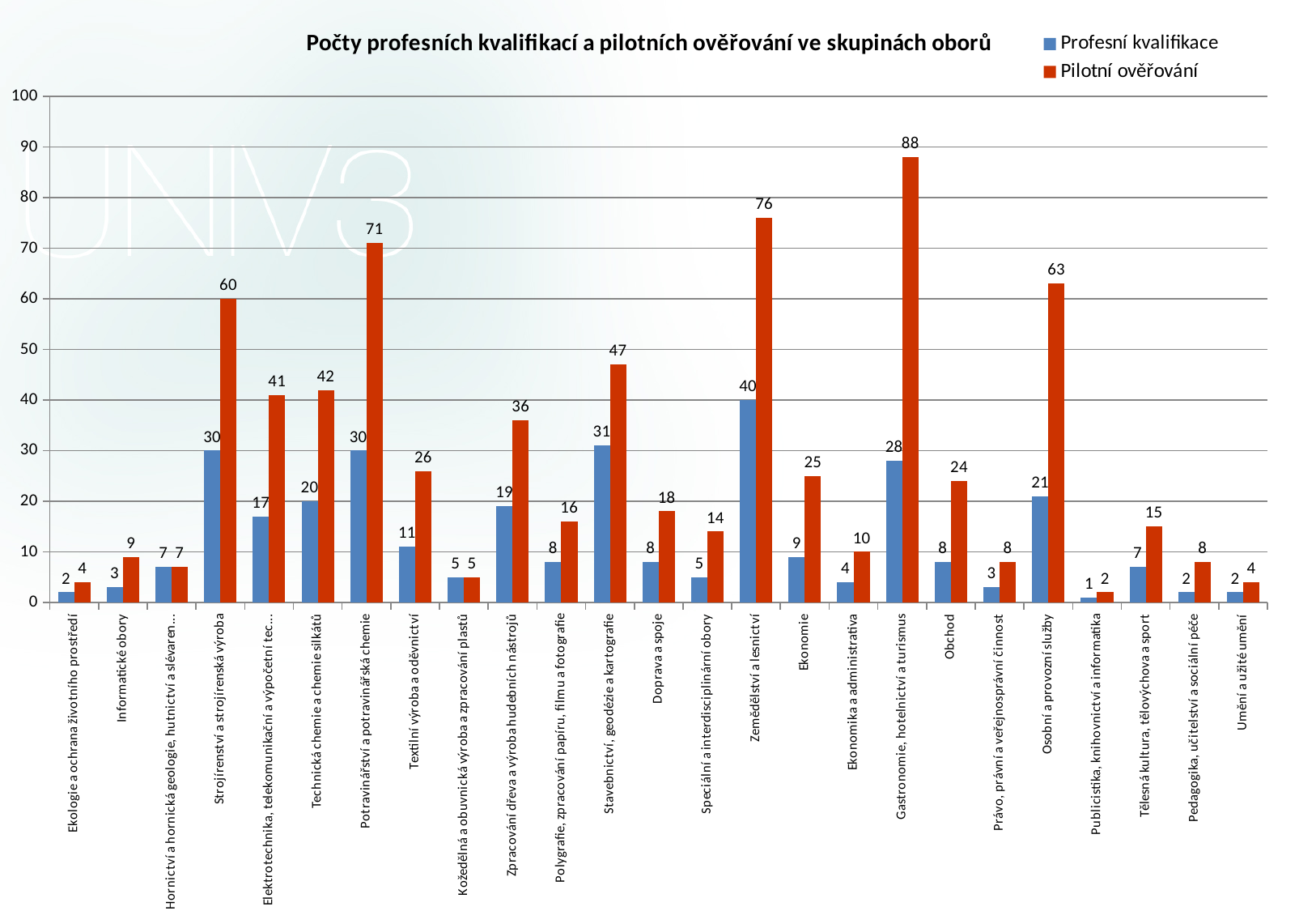
Which category has the highest value for Pilotní ověřování? Gastronomie, hotelnictví a turismus Which is larger: Pilotní ověřování for Strojírenství a strojírenská výroba or Pilotní ověřování for Stavebnictví, geodézie a kartografie? Strojírenství a strojírenská výroba What kind of chart is shown on the slide? bar chart Is the value of Pilotní ověřování for Zemědělství a lesnictví greater or less than 70? greater How many series does the legend list? 2 How many categories are shown on the x axis? 25 Which category has the lowest value for Profesní kvalifikace? Publicistika, knihovnictví a informatika Which category has the highest value for Profesní kvalifikace? Zemědělství a lesnictví What is the difference between Pilotní ověřování and Profesní kvalifikace for Potravinářství a potravinářská chemie? 41 What is the value of Pilotní ověřování for Osobní a provozní služby? 63 What is the value of Profesní kvalifikace for Zemědělství a lesnictví? 40 What is the value of Pilotní ověřování for Gastronomie, hotelnictví a turismus? 88